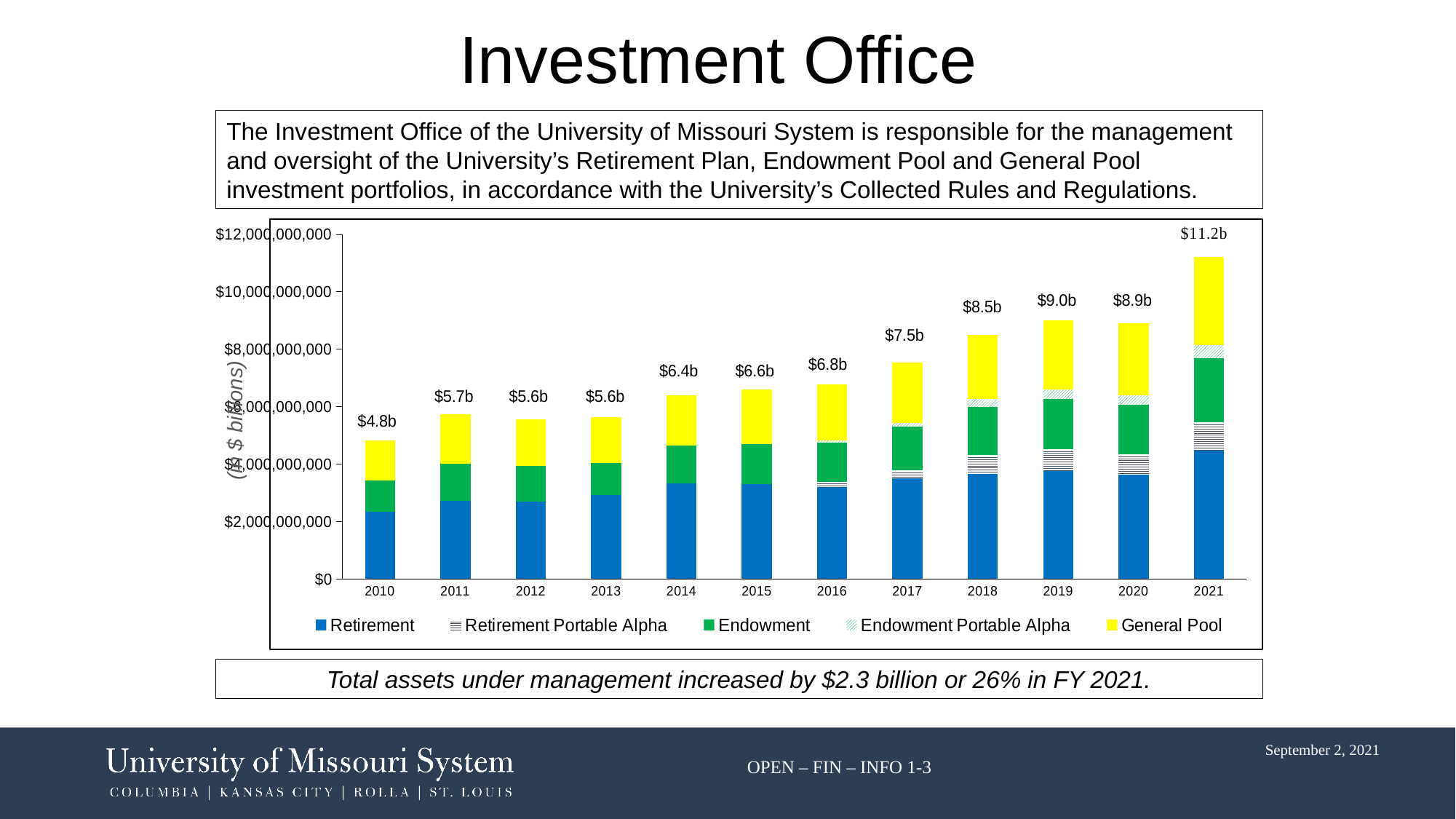
Which year has the highest total assets under management? 2021 What is the total labeled on the bar for 2021? $11.2b What is the total labeled on the bar for 2010? $4.8b Which year has the lowest total assets under management? 2010 What is the total labeled on the bar for 2017? $7.5b How many years are shown on the x axis of the chart? 12 Which series is shown in yellow in the chart? General Pool What kind of chart is shown on the slide? Stacked bar chart What is the difference between the labeled totals for 2021 and 2020? $2.3b How many series does the chart legend list? 5 Which year has the larger labeled total, 2019 or 2020? 2019 Is the Retirement segment for 2021 greater or less than $4,000,000,000? greater